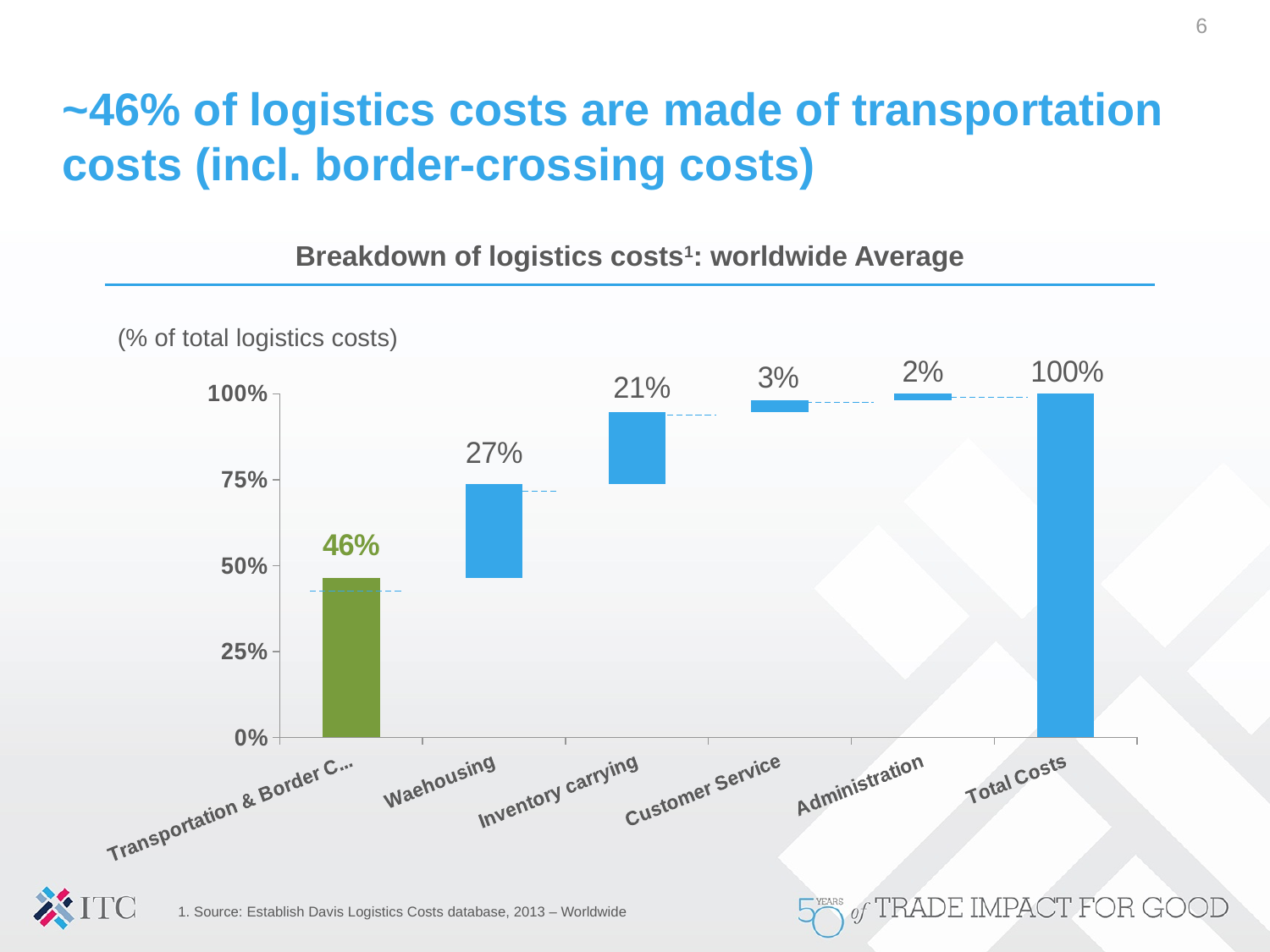
What kind of chart is shown on the slide? bar chart What is the value shown for the Transportation & Border C... bar? 46% What colour is the Transportation & Border C... bar? green What is the difference between the Waehousing value and the Inventory carrying value? 6% Which is larger, the value for Customer Service or the value for Administration? Customer Service What is the value shown for Waehousing? 27% What is the value shown for Administration? 2% How many categories are shown on the x axis? 6 Excluding Total Costs, which category has the highest value? Transportation & Border C... Which category has the lowest value? Administration What is the value shown for Inventory carrying? 21% What is the value shown for Customer Service? 3%